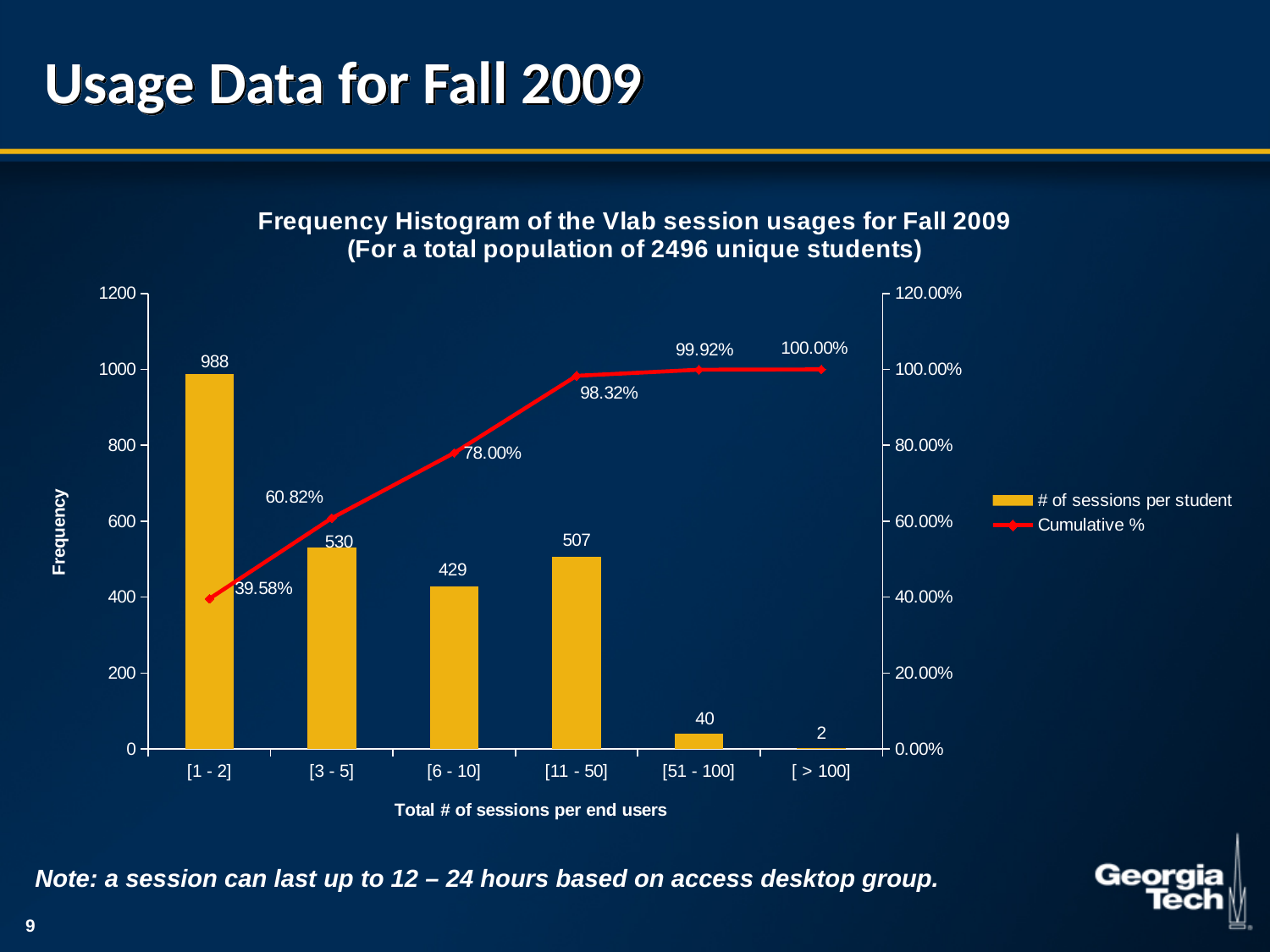
Which category has the highest number of sessions per student? [1 - 2] How many series does the legend list? 2 Which category has the lowest number of sessions per student? [ > 100] What is the number of sessions per student for the [51 - 100] category? 40 Does the Cumulative % line rise or fall from left to right along the x axis? Rise What is the label of the x axis? Total # of sessions per end users Which has a larger number of sessions per student, [3 - 5] or [11 - 50]? [3 - 5] How many categories are shown on the x axis? 6 What kind of chart is used for the # of sessions per student series? Bar chart What is the cumulative % at the [6 - 10] category? 78.00% What is the difference in number of sessions per student between the [3 - 5] and [6 - 10] categories? 101 What is the number of sessions per student for the [1 - 2] category? 988